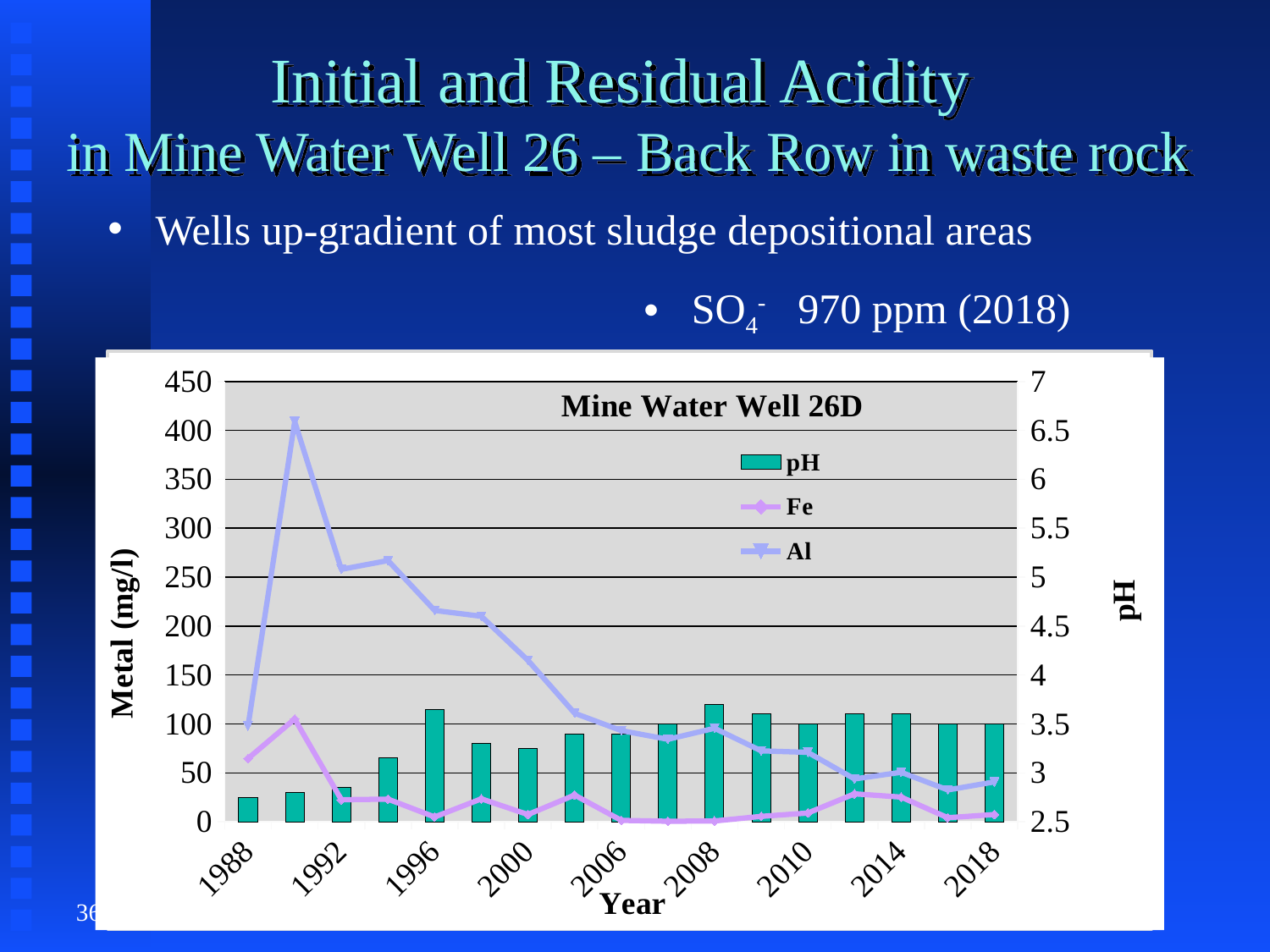
In 1996, which is higher, the Al value or the Fe value? Al Is the peak Al value (around 1990) greater or less than 350 mg/l? greater Is the Al value in 1996 greater or less than 200 mg/l? greater Is the Al value in 1988 greater or less than 150 mg/l? less What is the title of the chart on the slide? Mine Water Well 26D Which series in the chart is plotted as bars rather than a line? pH How many series does the chart legend list? 3 What kind of chart is shown on the slide? Combined bar and line chart Does the Al line generally rise or fall from 1990 to 2018? fall